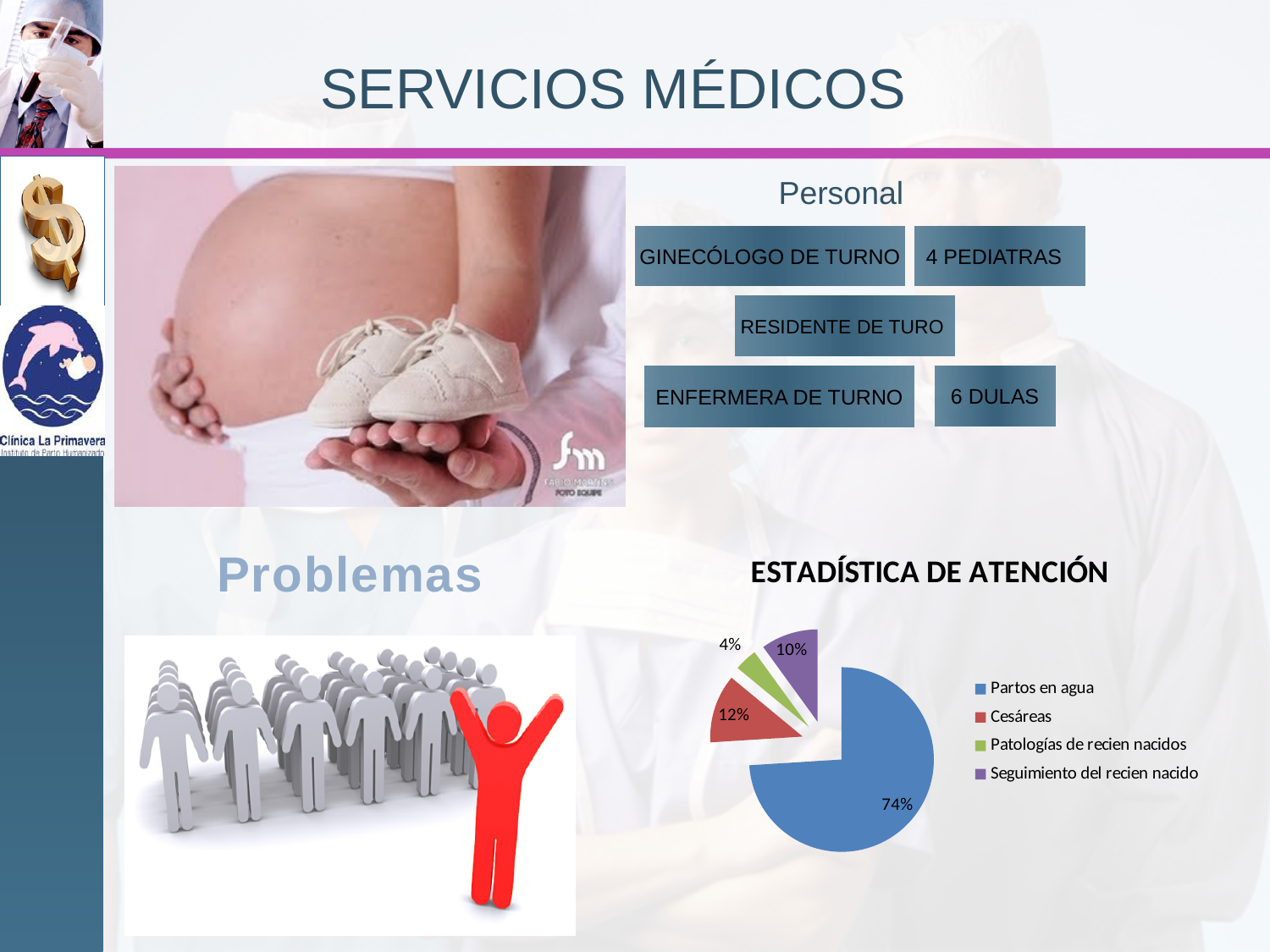
How many categories does the ESTADÍSTICA DE ATENCIÓN pie chart show? 4 In the ESTADÍSTICA DE ATENCIÓN pie chart, what share is labelled for Cesáreas? 12% Which category has the largest slice in the ESTADÍSTICA DE ATENCIÓN pie chart? Partos en agua What kind of chart is shown under the title ESTADÍSTICA DE ATENCIÓN? Pie chart In the ESTADÍSTICA DE ATENCIÓN pie chart, which is larger: Cesáreas or Seguimiento del recien nacido? Cesáreas What colour is the Partos en agua slice in the ESTADÍSTICA DE ATENCIÓN pie chart? Blue In the ESTADÍSTICA DE ATENCIÓN pie chart, what share is labelled for Partos en agua? 74% In the ESTADÍSTICA DE ATENCIÓN pie chart, what share is labelled for Patologías de recien nacidos? 4% In the ESTADÍSTICA DE ATENCIÓN pie chart, what share is labelled for Seguimiento del recien nacido? 10% Which category has the smallest slice in the ESTADÍSTICA DE ATENCIÓN pie chart? Patologías de recien nacidos What is the title of the pie chart on the slide? ESTADÍSTICA DE ATENCIÓN In the ESTADÍSTICA DE ATENCIÓN pie chart, what is the difference in percentage points between Partos en agua and Cesáreas? 62